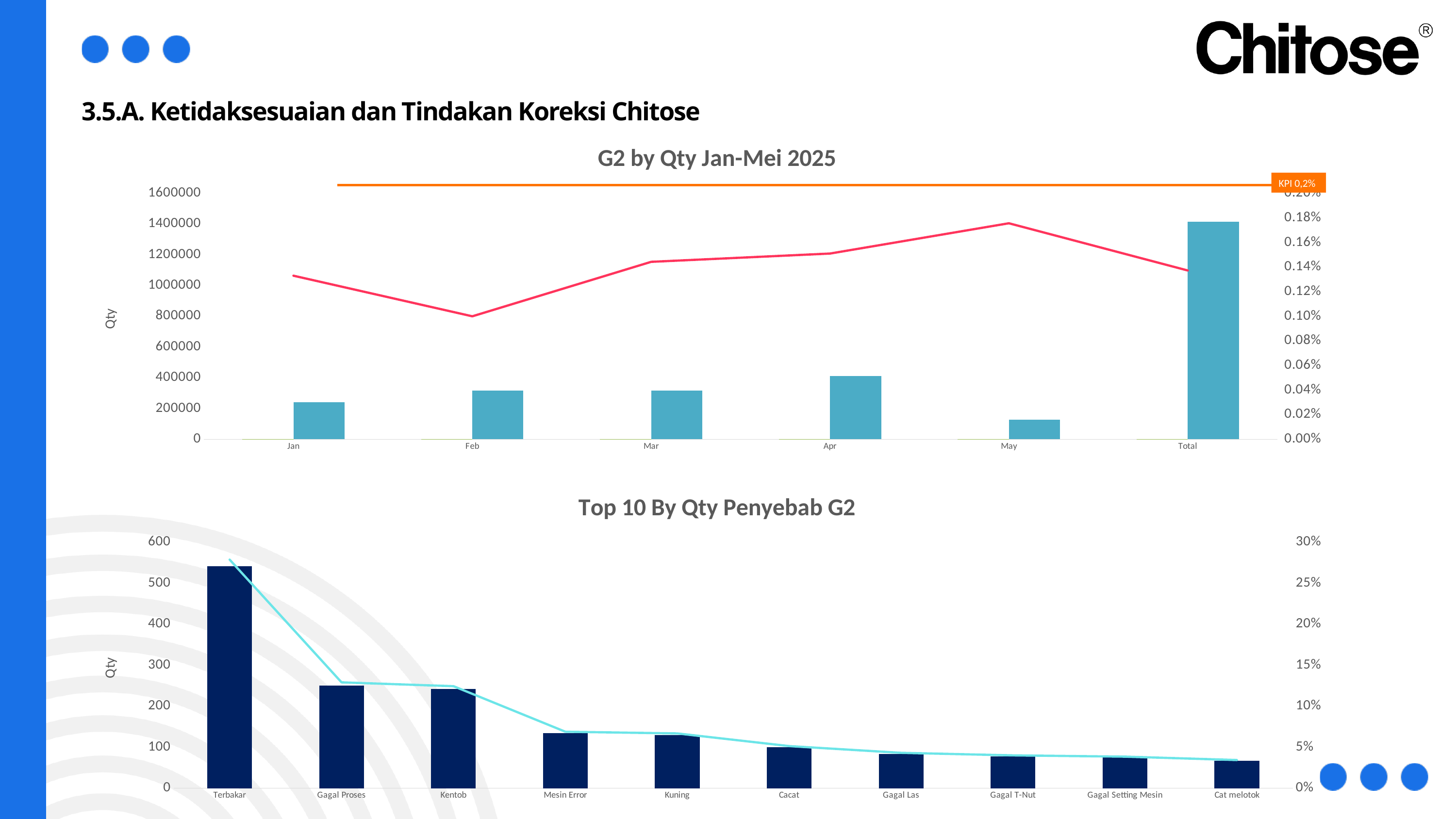
In the chart titled 'G2 by Qty Jan-Mei 2025', at which month does the red line reach its lowest point? Feb In the chart titled 'Top 10 By Qty Penyebab G2', which category has the highest bar? Terbakar In the chart titled 'Top 10 By Qty Penyebab G2', do the bar values rise or fall from left to right along the x axis? fall In the chart titled 'G2 by Qty Jan-Mei 2025', at which month does the red line reach its highest point? May In the chart titled 'G2 by Qty Jan-Mei 2025', is the bar value for Apr greater or less than 200000? greater In the chart titled 'Top 10 By Qty Penyebab G2', is the bar value for Terbakar greater or less than 500? greater In the chart titled 'G2 by Qty Jan-Mei 2025', is the bar value for May greater or less than 200000? less In the chart titled 'G2 by Qty Jan-Mei 2025', what KPI value is labelled on the orange line? KPI 0,2% In the chart titled 'G2 by Qty Jan-Mei 2025', which month has the shortest bar? May In the chart titled 'Top 10 By Qty Penyebab G2', how many categories are shown on the x axis? 10 In the chart titled 'G2 by Qty Jan-Mei 2025', which month has the tallest bar? Apr